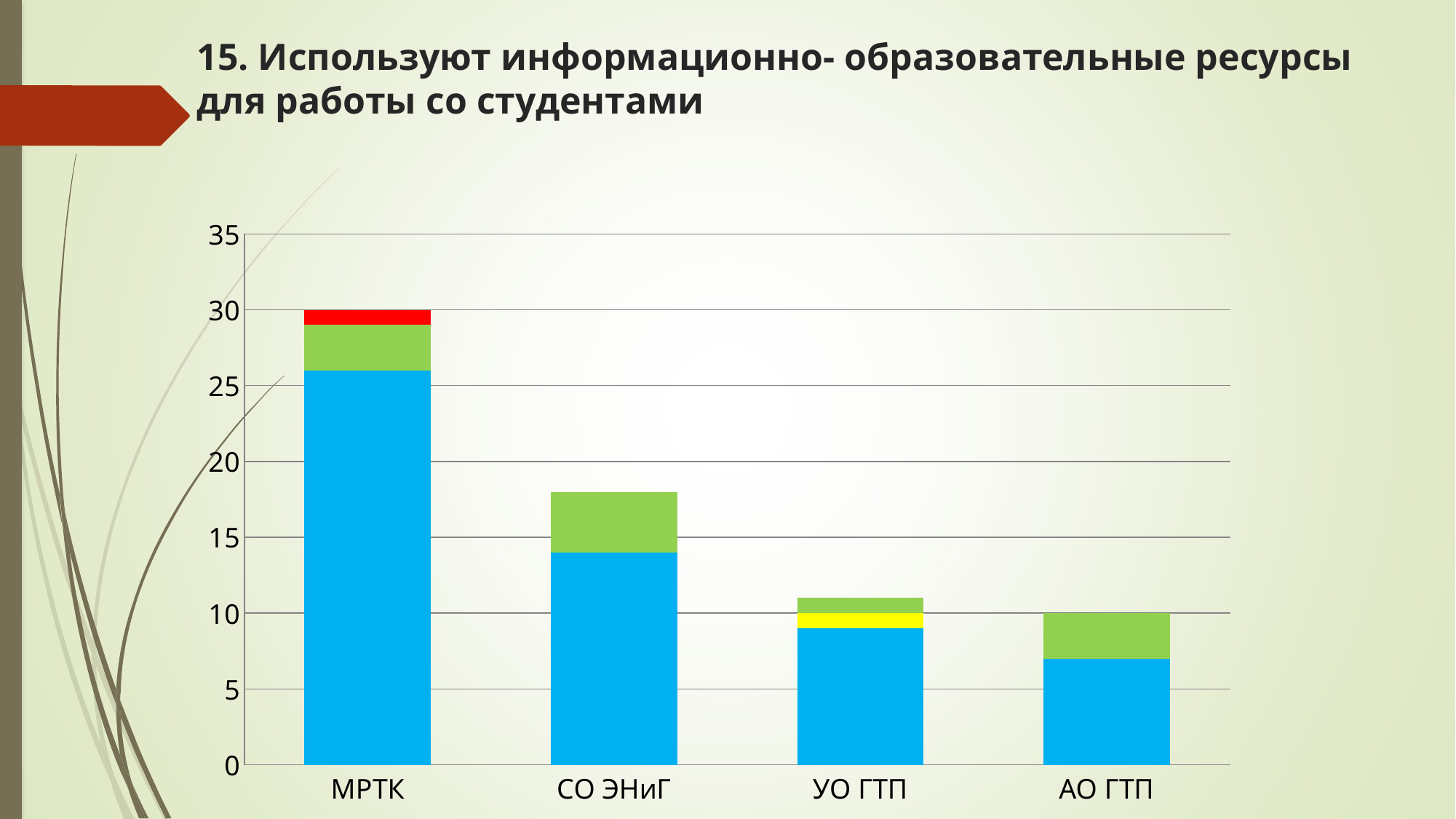
What is the total height of the stacked bar for МРТК? 30 Is the blue segment for МРТК greater or less than 25? greater Is the total value for СО ЭНиГ greater or less than 20? less What is the total height of the stacked bar for АО ГТП? 10 Which category has the tallest bar in the chart? МРТК Which category is the only one whose bar includes a red segment? МРТК Is the total value for СО ЭНиГ greater or less than 15? greater How many categories are shown on the x axis of the chart? 4 Do the bar totals rise or fall from left to right across the x axis? fall Which bar is taller, СО ЭНиГ or УО ГТП? СО ЭНиГ What kind of chart is shown on the slide? stacked bar chart